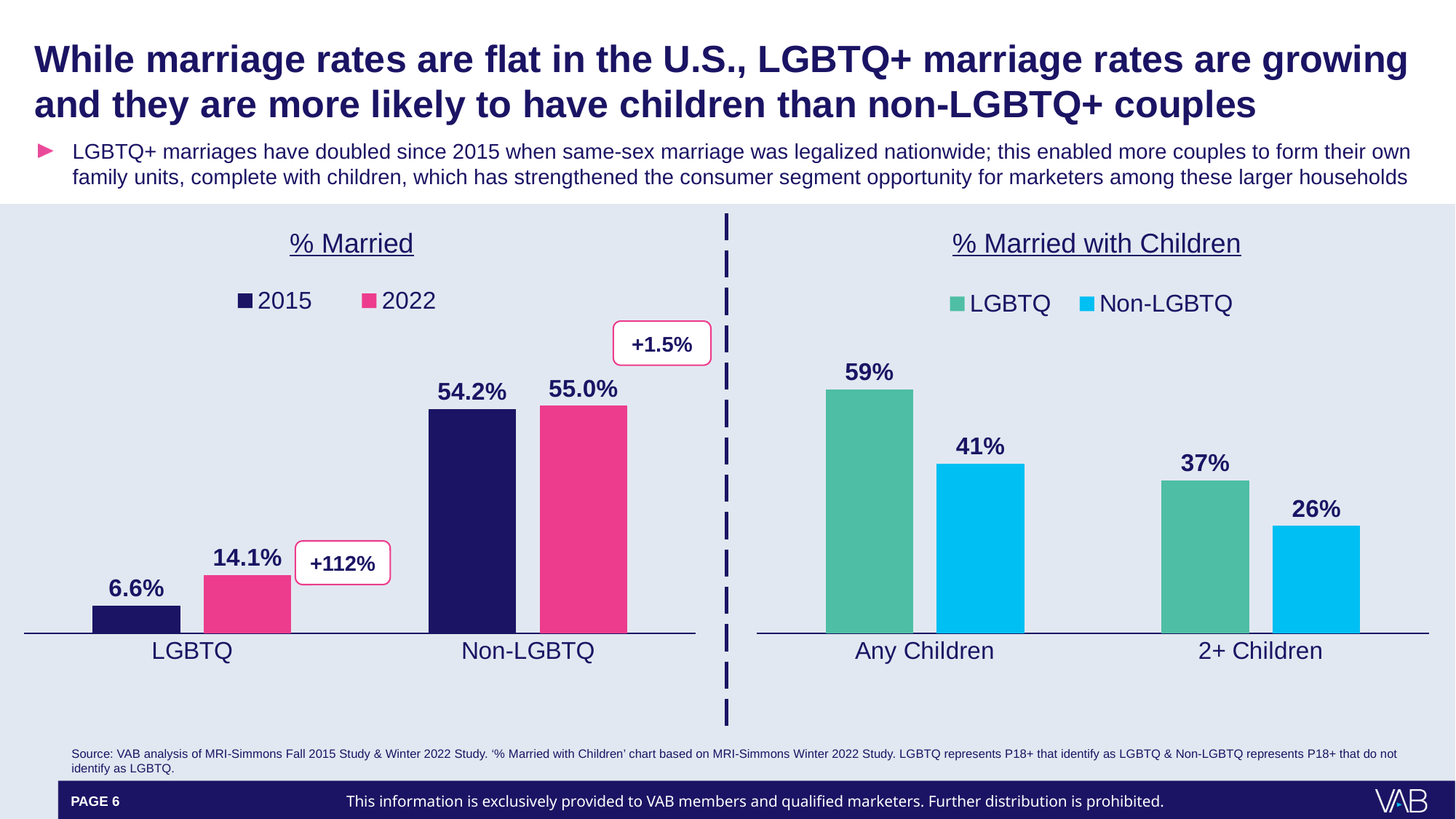
In the '% Married with Children' chart, what is the LGBTQ value for Any Children? 59% In the '% Married' chart, how many series does the legend list? 2 In the '% Married with Children' chart, what is the difference between the LGBTQ and Non-LGBTQ values for Any Children? 18% In the '% Married' chart, what is the 2015 value for LGBTQ? 6.6% What kind of chart is the '% Married with Children' chart? Bar chart In the '% Married' chart, what is the difference between the 2022 and 2015 values for LGBTQ? 7.5% In the '% Married with Children' chart, which is larger for 2+ Children: LGBTQ or Non-LGBTQ? LGBTQ In the '% Married' chart, what is the 2022 value for Non-LGBTQ? 55.0% In the '% Married' chart, what percentage change is shown in the callout next to the LGBTQ bars? +112% In the '% Married with Children' chart, how many categories are shown on the x axis? 2 In the '% Married with Children' chart, what is the Non-LGBTQ value for 2+ Children? 26% In the '% Married' chart, which category has the highest 2022 value? Non-LGBTQ